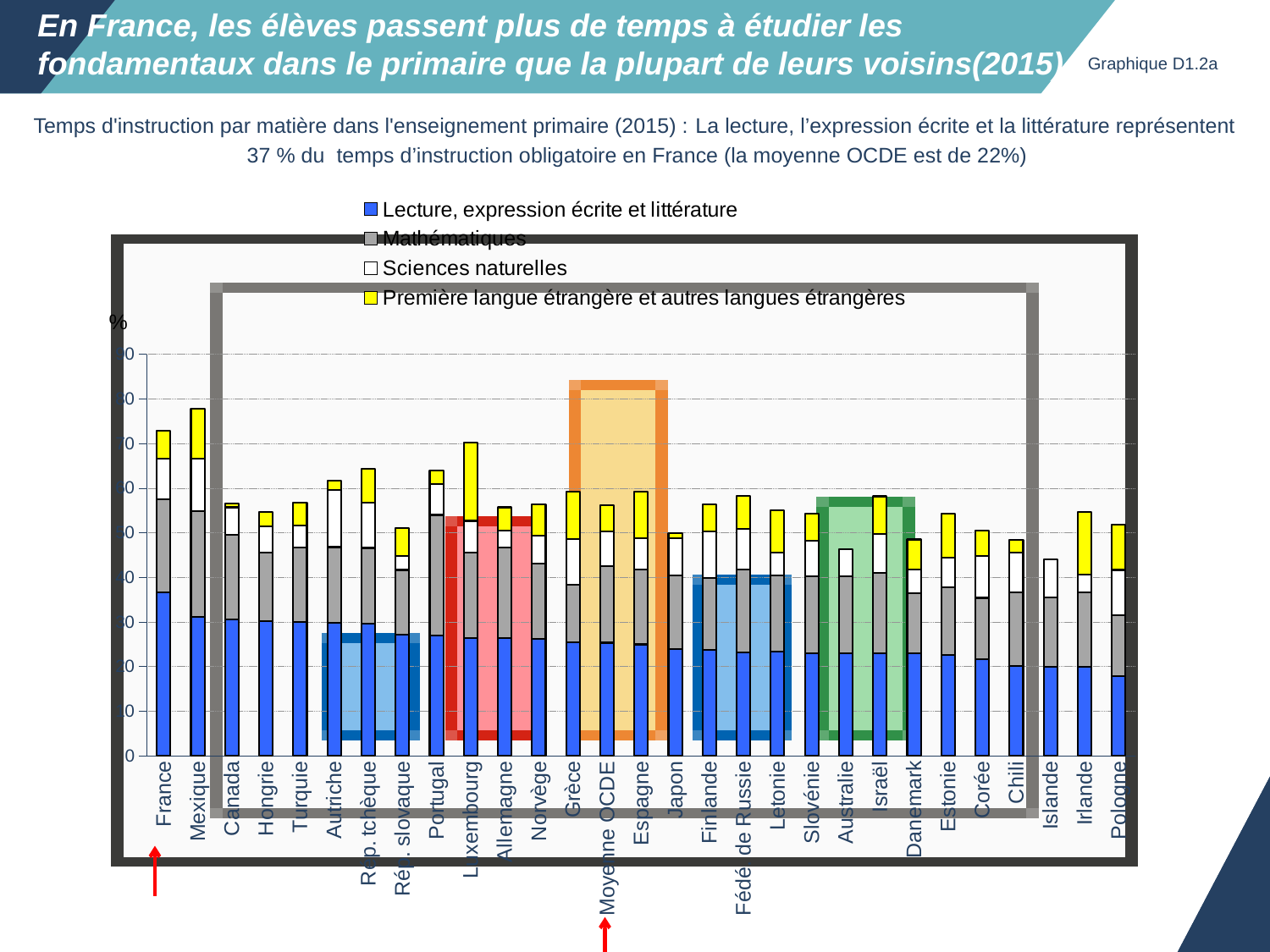
Do the blue segments (Lecture, expression écrite et littérature) generally rise or fall from left to right along the x axis? Fall Which category has the tallest stacked bar overall? Mexique According to the slide text, what is the OECD average share of instruction time for reading, writing and literature? 22% Which category has the tallest blue segment (Lecture, expression écrite et littérature)? France Which category has the shortest stacked bar overall? Islande Is the blue segment for France larger or smaller than the blue segment for Moyenne OCDE? Larger Which colour represents 'Première langue étrangère et autres langues étrangères' in the legend? Yellow According to the slide text, what share of compulsory instruction time in France is devoted to reading, writing and literature? 37 % How many countries or categories are shown along the x axis? 29 What kind of chart is shown on the slide? Stacked bar chart How many series does the legend list? 4 Which category has the shortest blue segment (Lecture, expression écrite et littérature)? Pologne